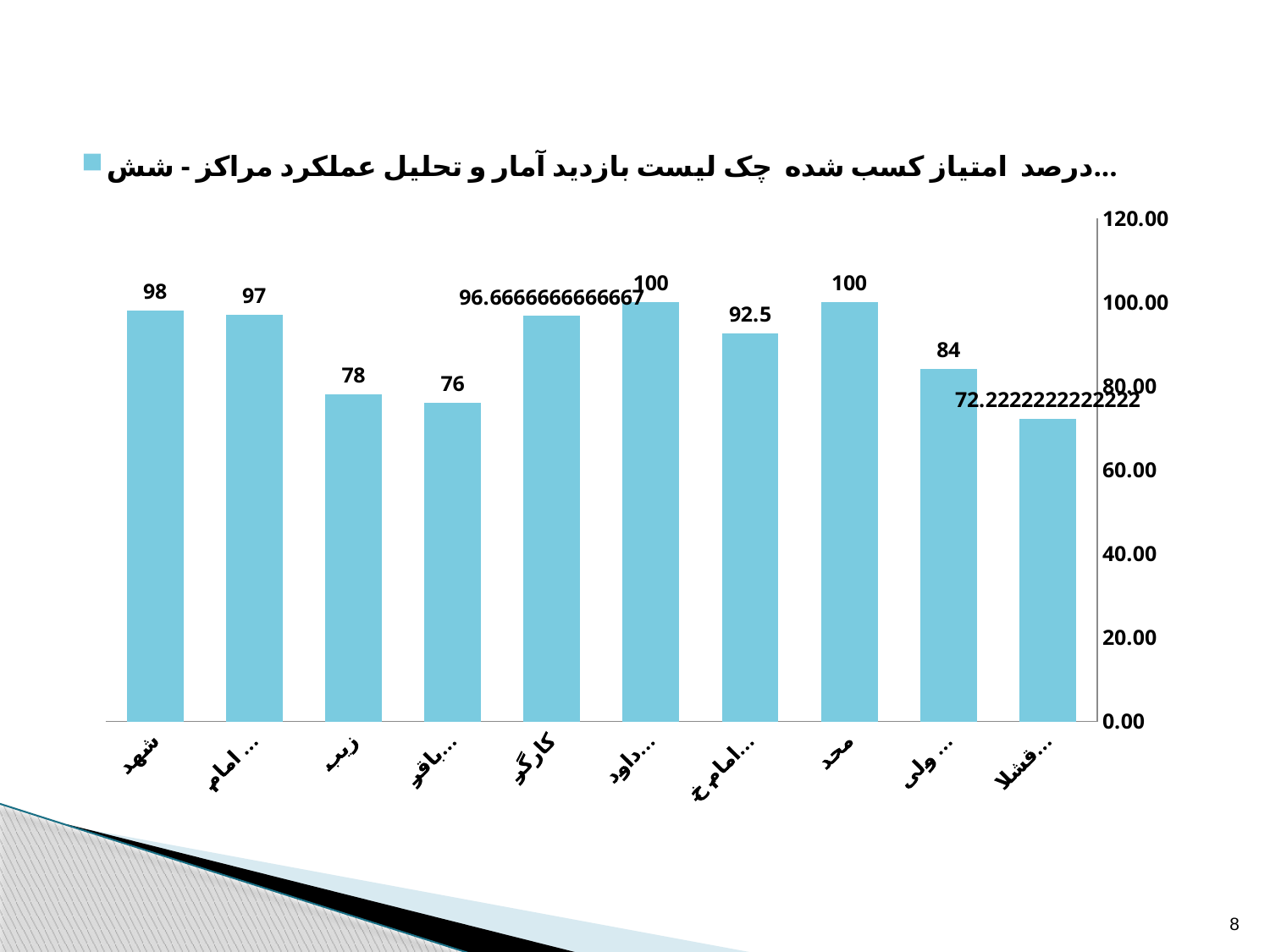
What is the value for کارگر? 96.6666666666667 Which is larger, the value for شهد or the value for کارگر? شهد How many series does the legend list? 1 What kind of chart is shown on the slide? bar chart What is the value for محد? 100 What is the highest value shown on the chart? 100 What is the value for شهد? 98 What is the lowest value shown on the chart? 72.2222222222222 How many bars are plotted on the chart? 10 How many bars reach the value 100? 2